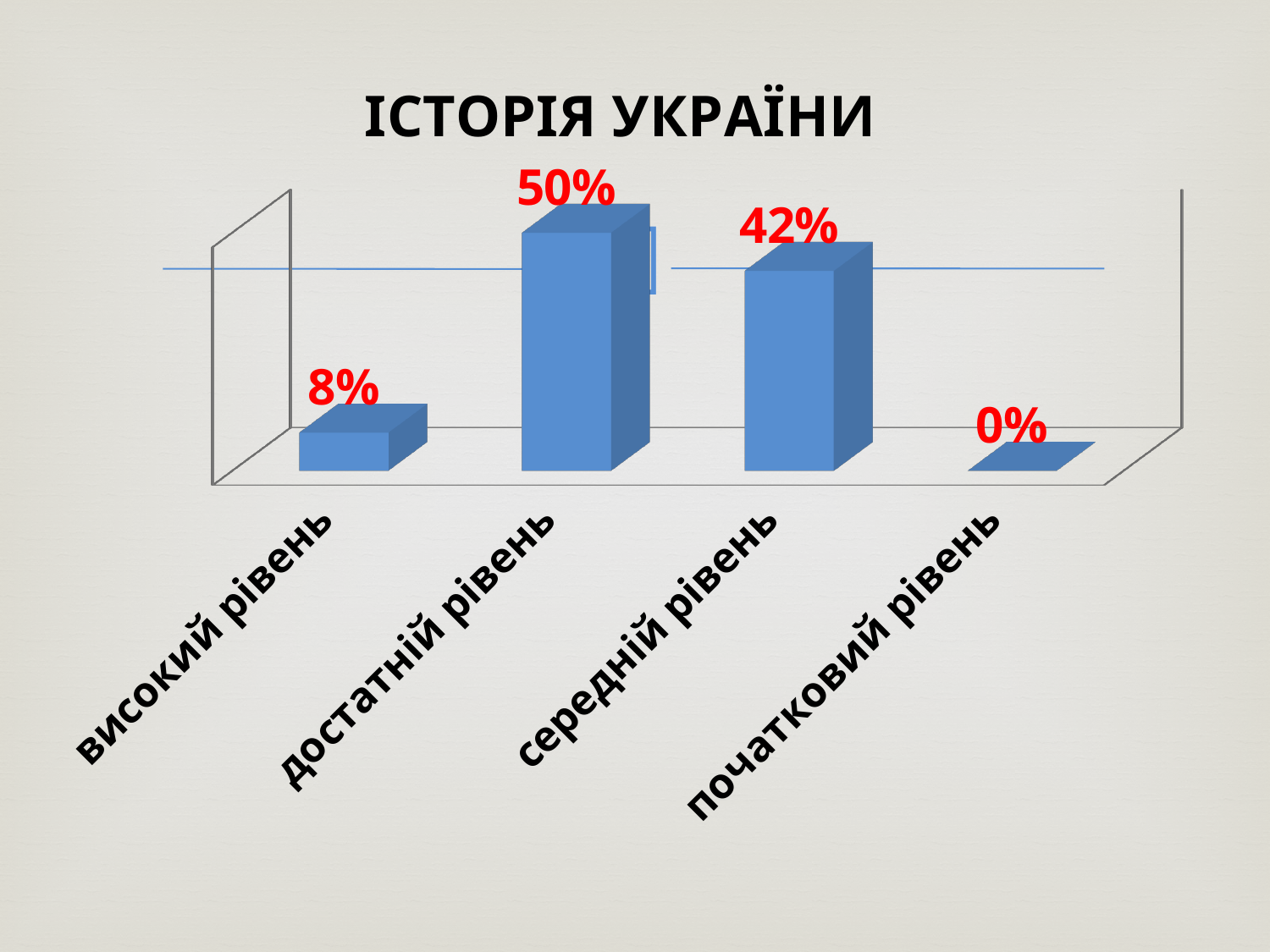
What is the value for початковий рівень? 0% What is the title of the chart? ІСТОРІЯ УКРАЇНИ What kind of chart is shown on the slide? bar chart What is the value for високий рівень? 8% How many categories are shown in the chart? 4 Which category has the highest value? достатній рівень What is the value for середній рівень? 42% What is the difference between the values for середній рівень and високий рівень? 34% Which category has the lowest value? початковий рівень What is the value for достатній рівень? 50% What is the difference between the values for достатній рівень and середній рівень? 8% Which is larger, the value for високий рівень or the value for середній рівень? середній рівень